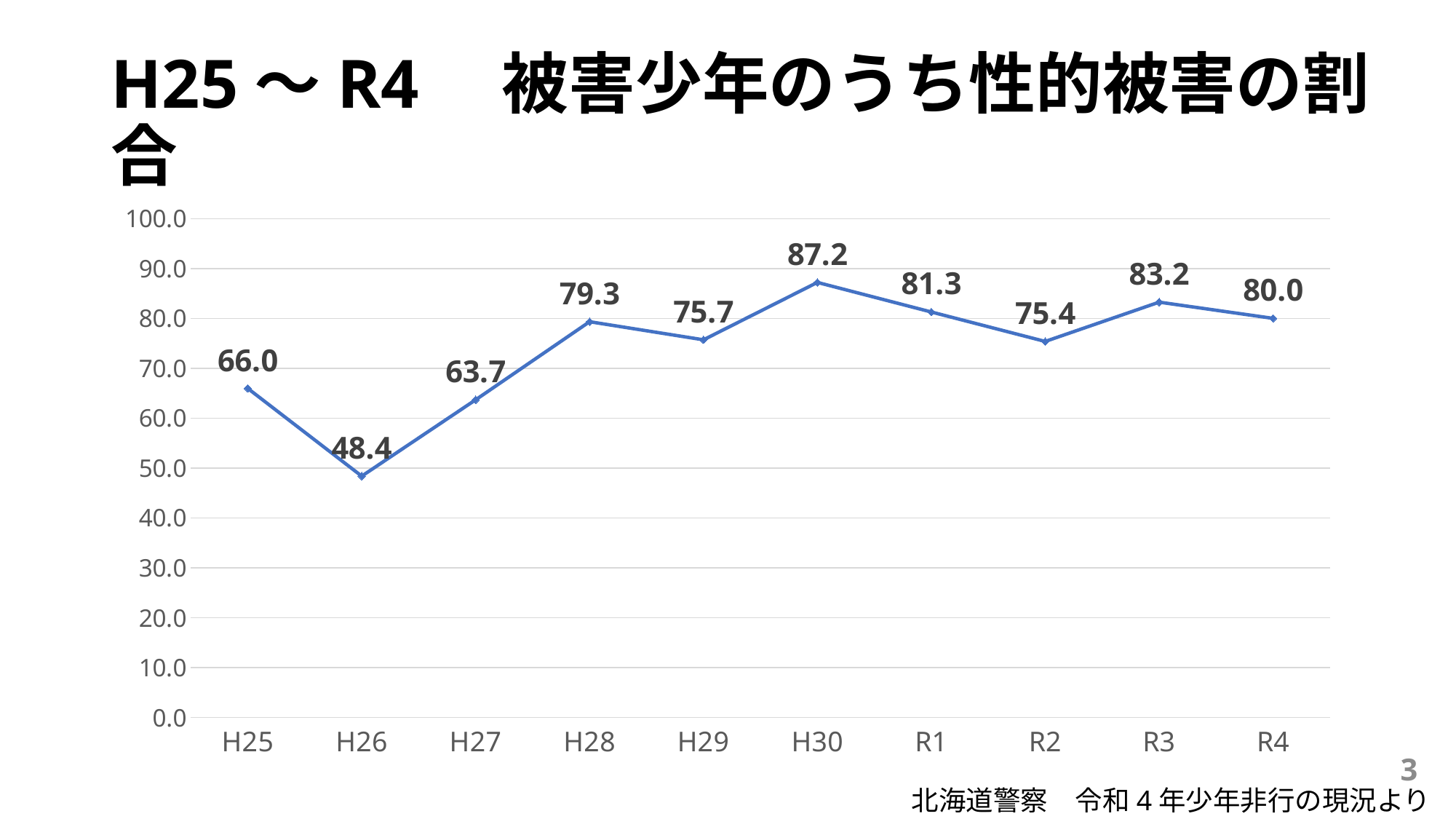
Which is larger, the value for H25 or the value for H27? H25 Does the value rise or fall from H25 to H26? fall Which year has the lowest value? H26 What kind of chart is shown on the slide? line chart What is the difference between the values for R3 and R2? 7.8 What is the value for R4? 80.0 What is the value for H30? 87.2 What is the difference between the values for H30 and H26? 38.8 What is the value for H26? 48.4 Which year has the highest value? H30 How many years are plotted on the x axis? 10 Is the value for H28 greater or less than 70.0? greater